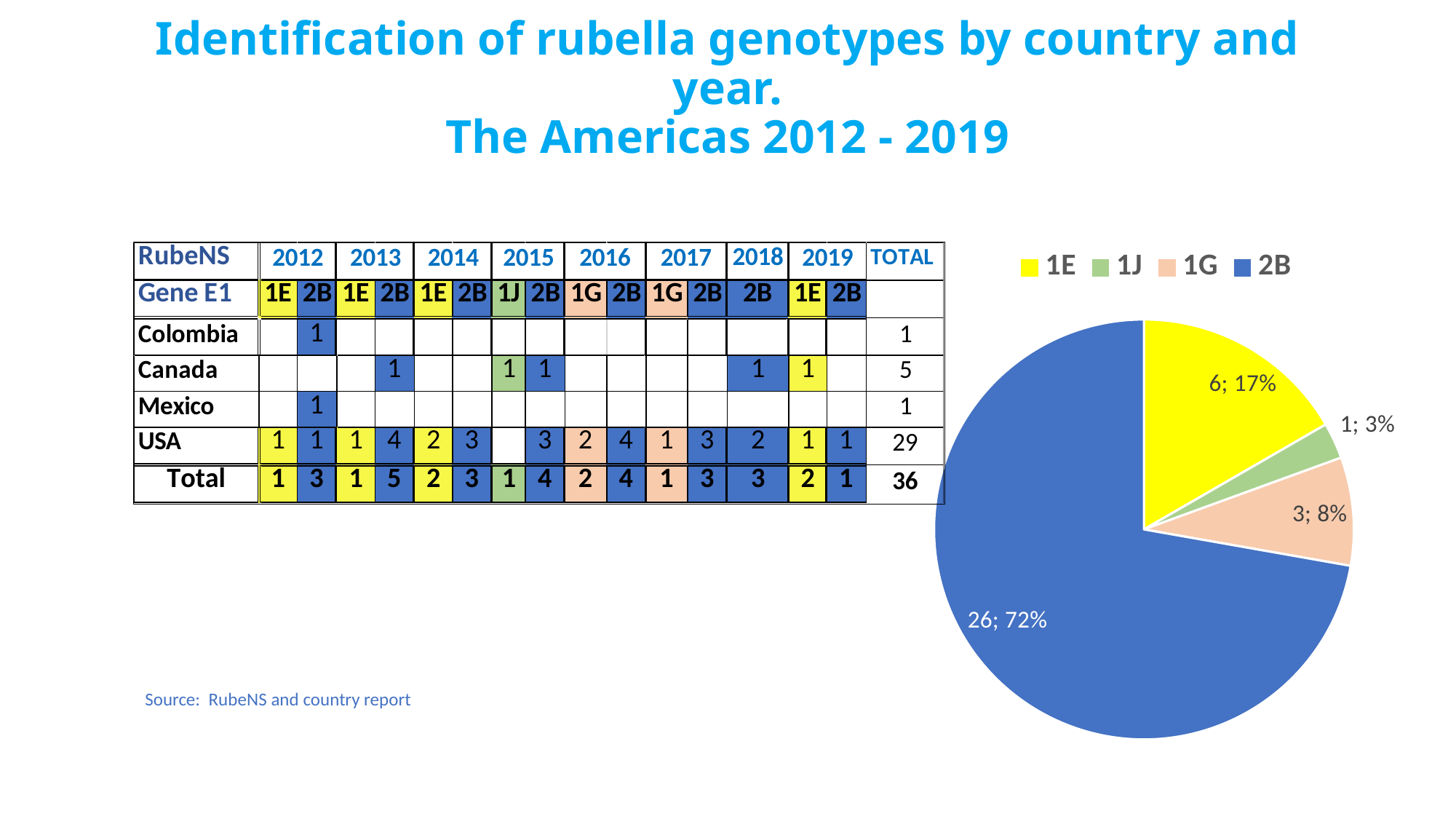
In the pie chart, which has a larger count, 1G or 1E? 1E What type of chart is shown on the slide? pie chart Which genotype has the smallest slice in the pie chart? 1J What colour represents genotype 1E in the pie chart? yellow What count is shown for genotype 1J in the pie chart? 1 How many genotypes does the pie chart legend list? 4 What percentage share does genotype 2B have in the pie chart? 72% What percentage share does genotype 1E have in the pie chart? 17% What count is shown for genotype 2B in the pie chart? 26 What percentage share does genotype 1G have in the pie chart? 8% In the pie chart, what is the difference between the counts for 2B and 1E? 20 Which genotype has the largest slice in the pie chart? 2B